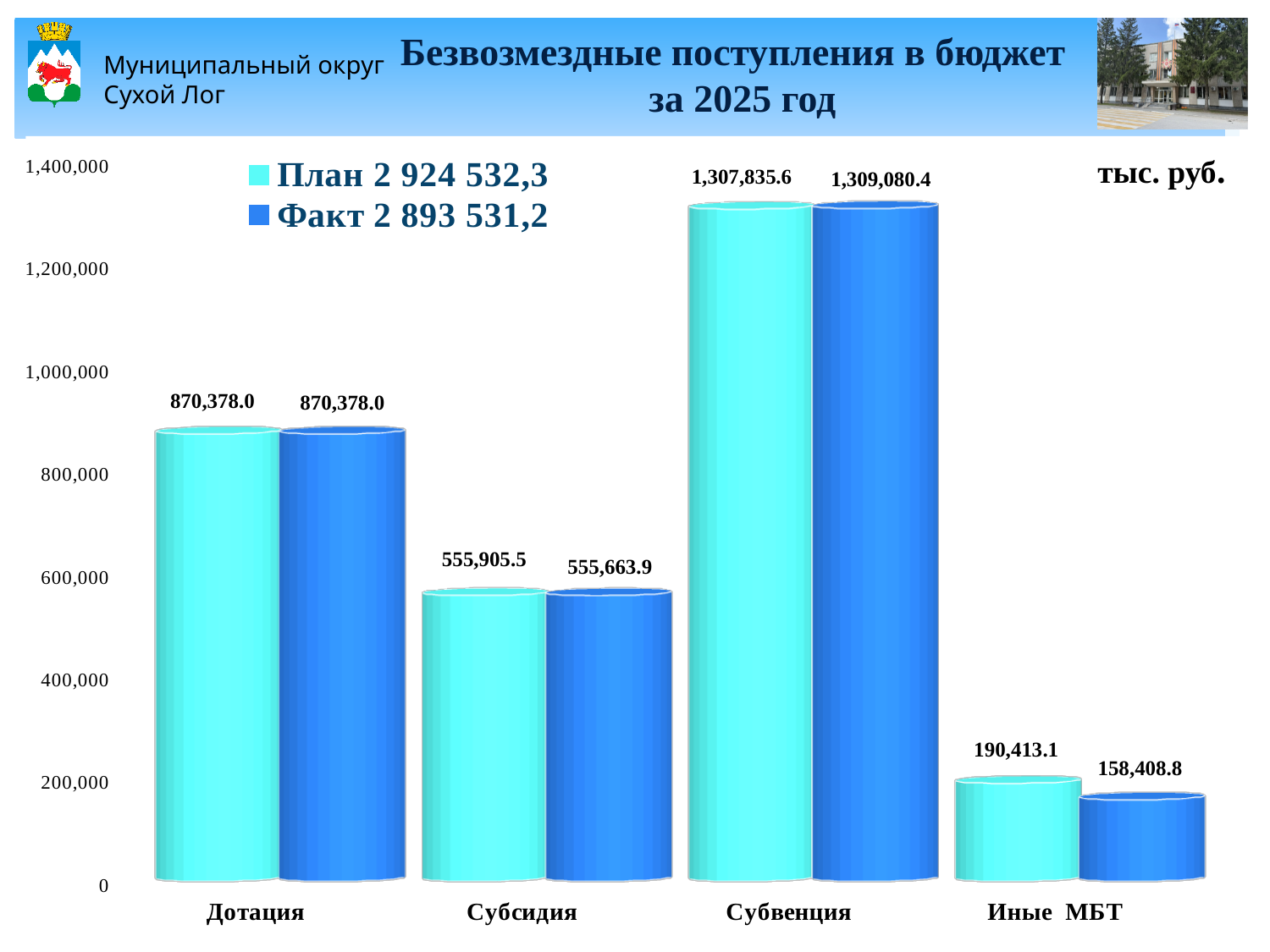
For Субвенция, which is larger: the План value or the Факт value? Факт What is the План value for Субвенция? 1,307,835.6 How many series does the legend list? 2 Which category has the lowest План value? Иные МБТ What is the difference between the Факт and План values for Субвенция? 1,244.8 What is the Факт value for Субсидия? 555,663.9 Which category has the highest Факт value? Субвенция What is the difference between the План and Факт values for Иные МБТ? 32,004.3 How many categories are shown on the x axis? 4 What kind of chart is shown on the slide? Bar chart What is the План value for Дотация? 870,378.0 What is the Факт value for Иные МБТ? 158,408.8